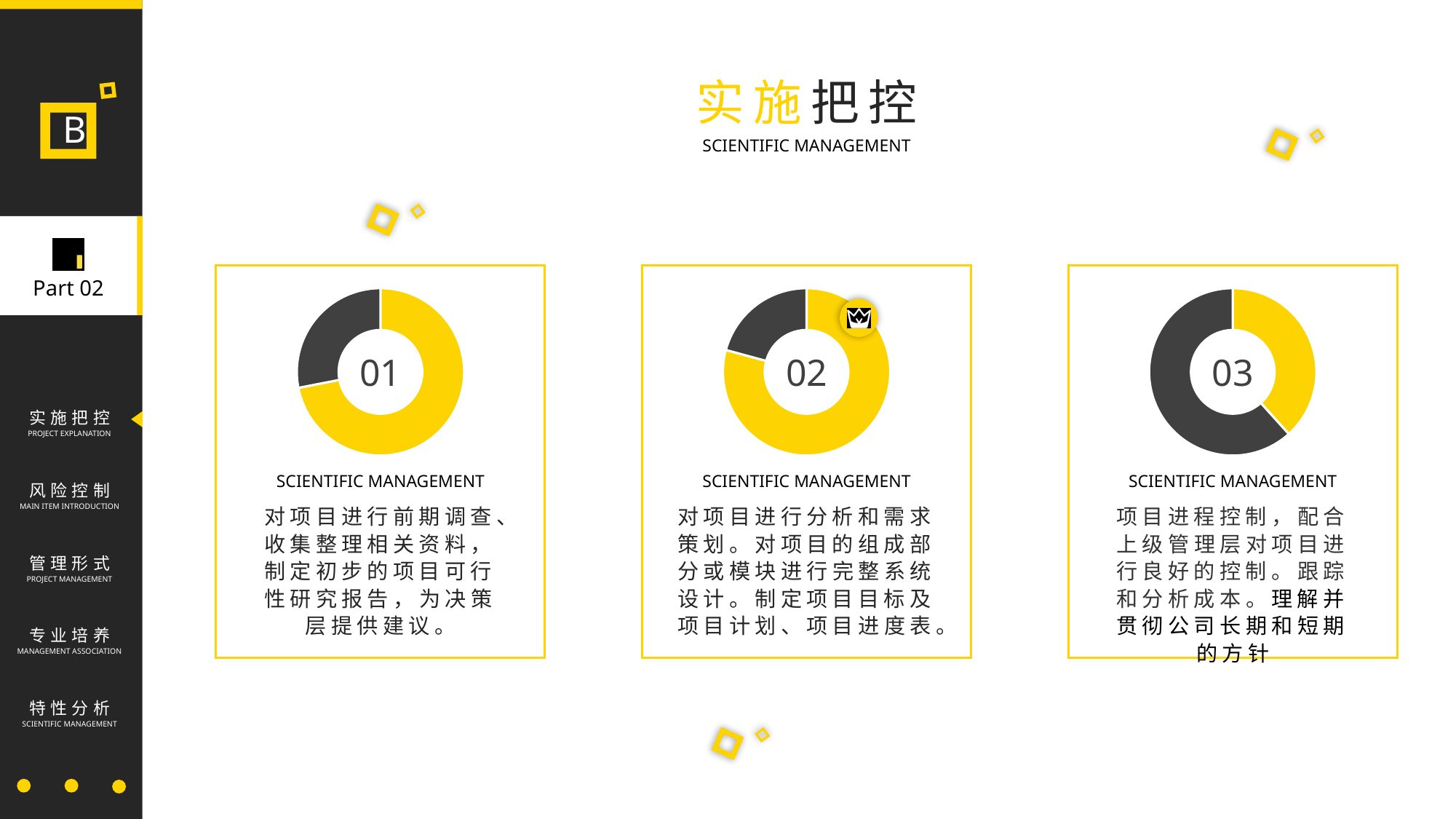
How many donut charts are shown on the slide? 3 In the donut chart labelled 01, which slice is larger, the yellow one or the dark grey one? Yellow In the donut chart labelled 03, which slice is larger, the yellow one or the dark grey one? Dark grey What caption appears directly below each donut chart? SCIENTIFIC MANAGEMENT What kind of chart is shown in the right card labelled 03? Donut chart What number is printed in the centre of the middle donut chart? 02 How many slices does the donut chart labelled 01 have? 2 How many slices does the donut chart labelled 02 have? 2 In the donut chart labelled 02, which slice is larger, the yellow one or the dark grey one? Yellow What kind of chart is shown in the left card labelled 01? Donut chart